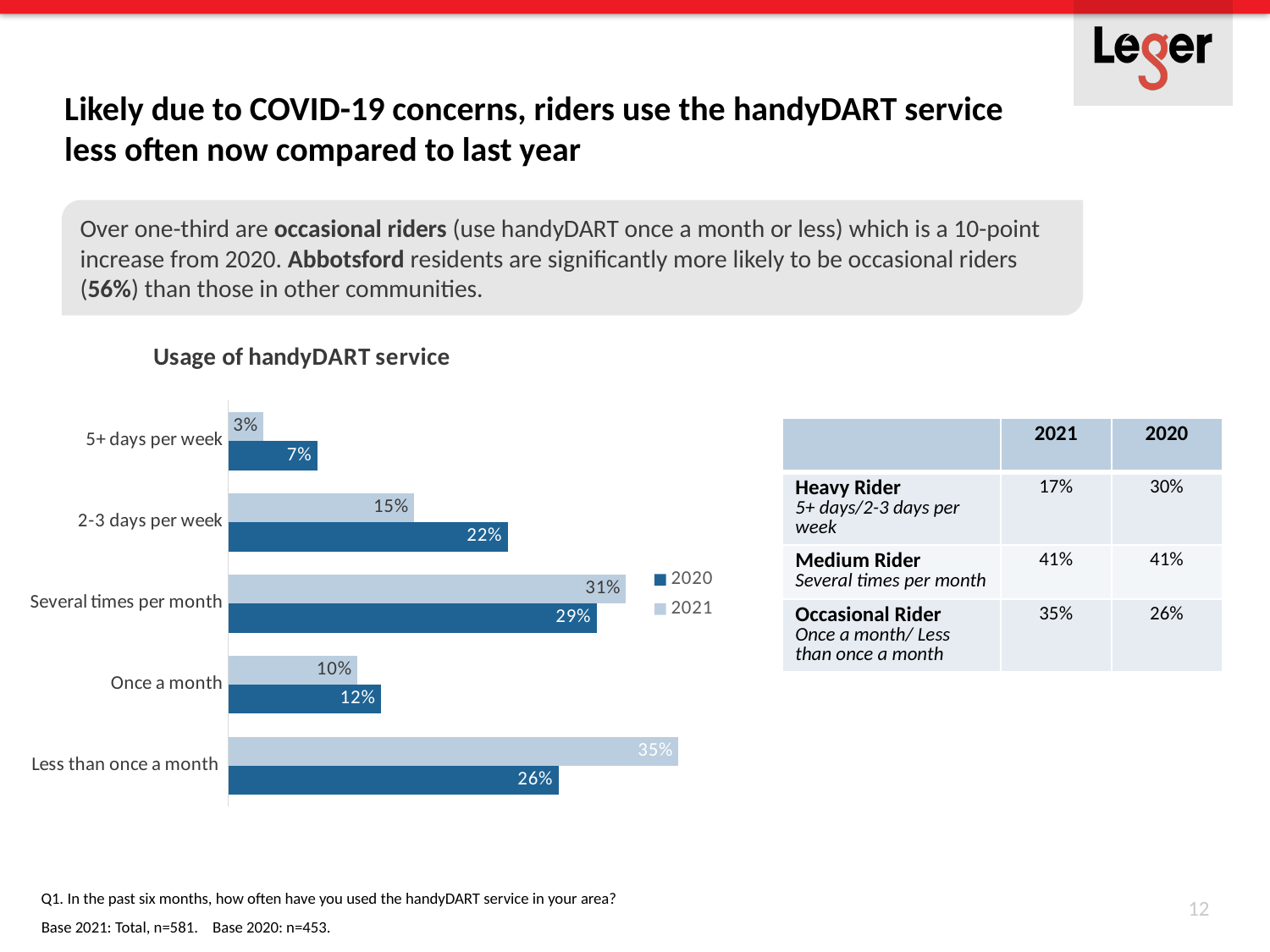
How many categories are shown in the Usage of handyDART service chart? 5 What is the 2020 value for '2-3 days per week' in the Usage of handyDART service chart? 22% How many series does the legend of the Usage of handyDART service chart list? 2 What is the 2021 value for 'Less than once a month' in the Usage of handyDART service chart? 35% What is the 2020 value for 'Several times per month' in the Usage of handyDART service chart? 29% In the Usage of handyDART service chart, what is the difference between the 2021 and 2020 values for 'Less than once a month'? 9% Which series is shown in dark blue in the Usage of handyDART service chart? 2020 What type of chart is the Usage of handyDART service chart? Bar chart In the Usage of handyDART service chart, is the 2020 value for 'Once a month' larger or smaller than the 2021 value? larger What is the 2021 value for '5+ days per week' in the Usage of handyDART service chart? 3% Which category has the highest 2021 value in the Usage of handyDART service chart? Less than once a month Which category has the lowest 2020 value in the Usage of handyDART service chart? 5+ days per week